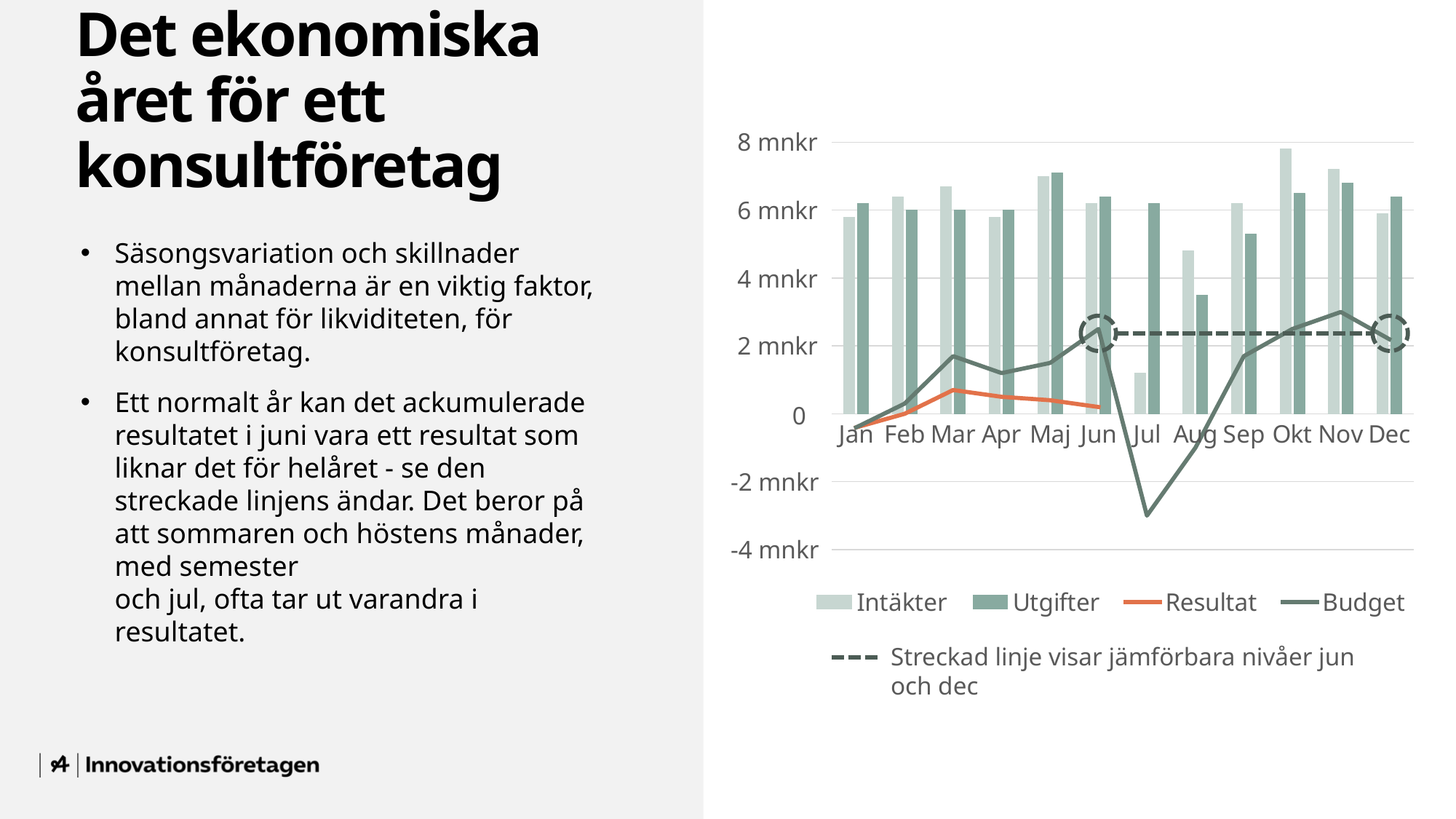
Is the value of Utgifter in Aug greater or less than 4 mnkr? less In Aug, which is larger: Intäkter or Utgifter? Intäkter Is the value of Intäkter in Okt greater or less than 6 mnkr? greater What type of chart is shown on the slide? Combined bar and line chart Does the Budget line rise or fall from Jun to Jul? Fall How many months are shown on the x axis of the chart? 12 How many entries does the chart legend list? 5 In which month does the Budget line reach its lowest point? Jul In which month is Intäkter lowest? Jul In which month is Utgifter lowest? Aug Is the Budget value in Jul greater or less than -2 mnkr? less In which month is Intäkter highest? Okt